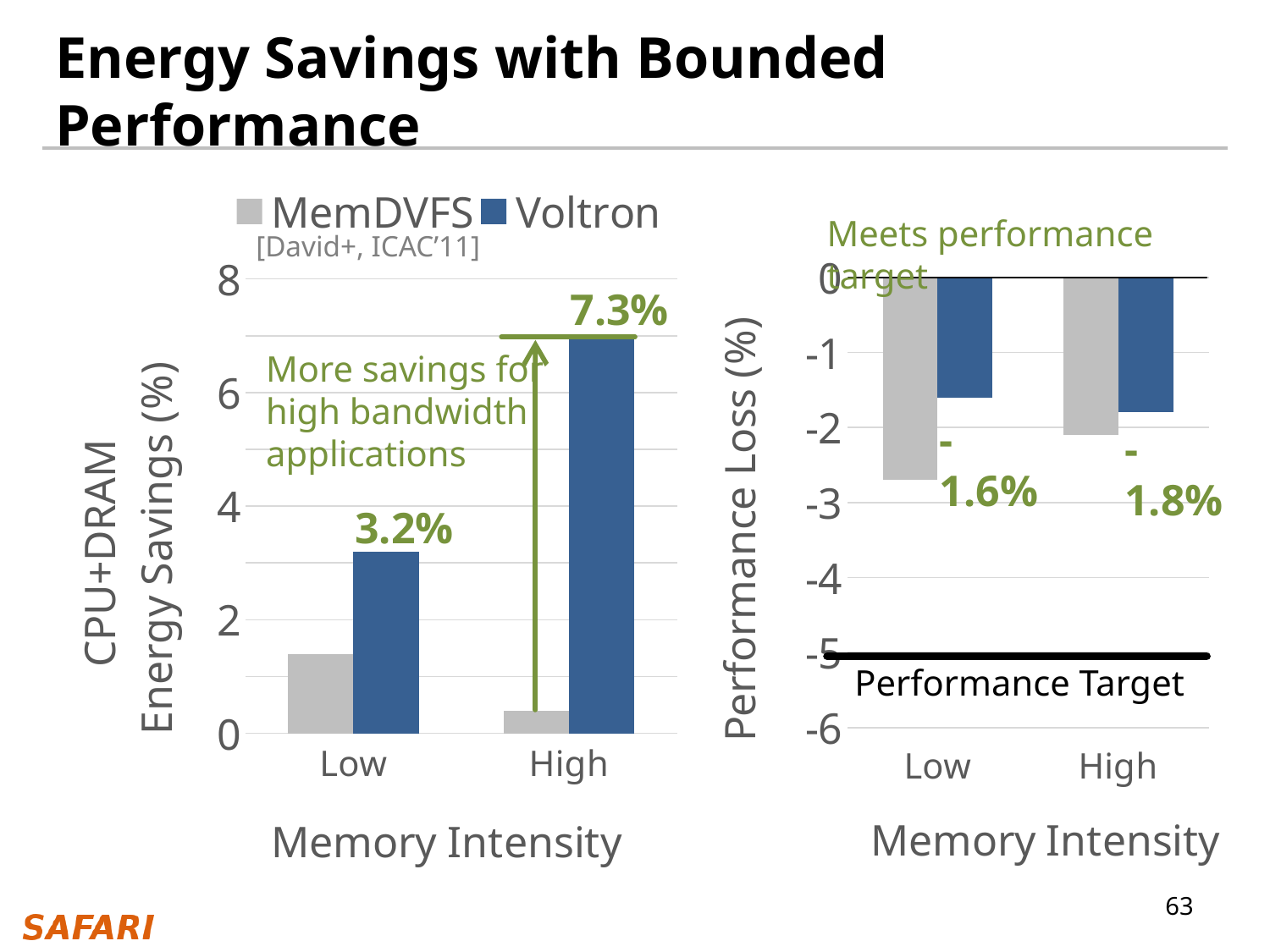
What kind of chart is the right chart (Performance Loss)? bar chart How many series does the legend of the left chart (CPU+DRAM Energy Savings) list? 2 In the left chart (CPU+DRAM Energy Savings), which series has the larger value at High memory intensity, MemDVFS or Voltron? Voltron In the right chart (Performance Loss), what is the performance loss for Voltron at High memory intensity? -1.8% In the left chart (CPU+DRAM Energy Savings), what is the energy savings for Voltron at High memory intensity? 7.3% How many memory intensity categories are shown on the x axis of the right chart (Performance Loss)? 2 In the left chart (CPU+DRAM Energy Savings), what is the difference between Voltron's savings at High and at Low memory intensity? 4.1 percentage points In the left chart (CPU+DRAM Energy Savings), what is the energy savings for Voltron at Low memory intensity? 3.2% In the left chart (CPU+DRAM Energy Savings), is the value for MemDVFS at Low memory intensity greater or less than 2? less In the right chart (Performance Loss), what is the performance loss for Voltron at Low memory intensity? -1.6% In the left chart (CPU+DRAM Energy Savings), do Voltron's energy savings rise or fall from Low to High memory intensity? rise In the right chart (Performance Loss), at what y-axis value is the Performance Target line drawn? -5